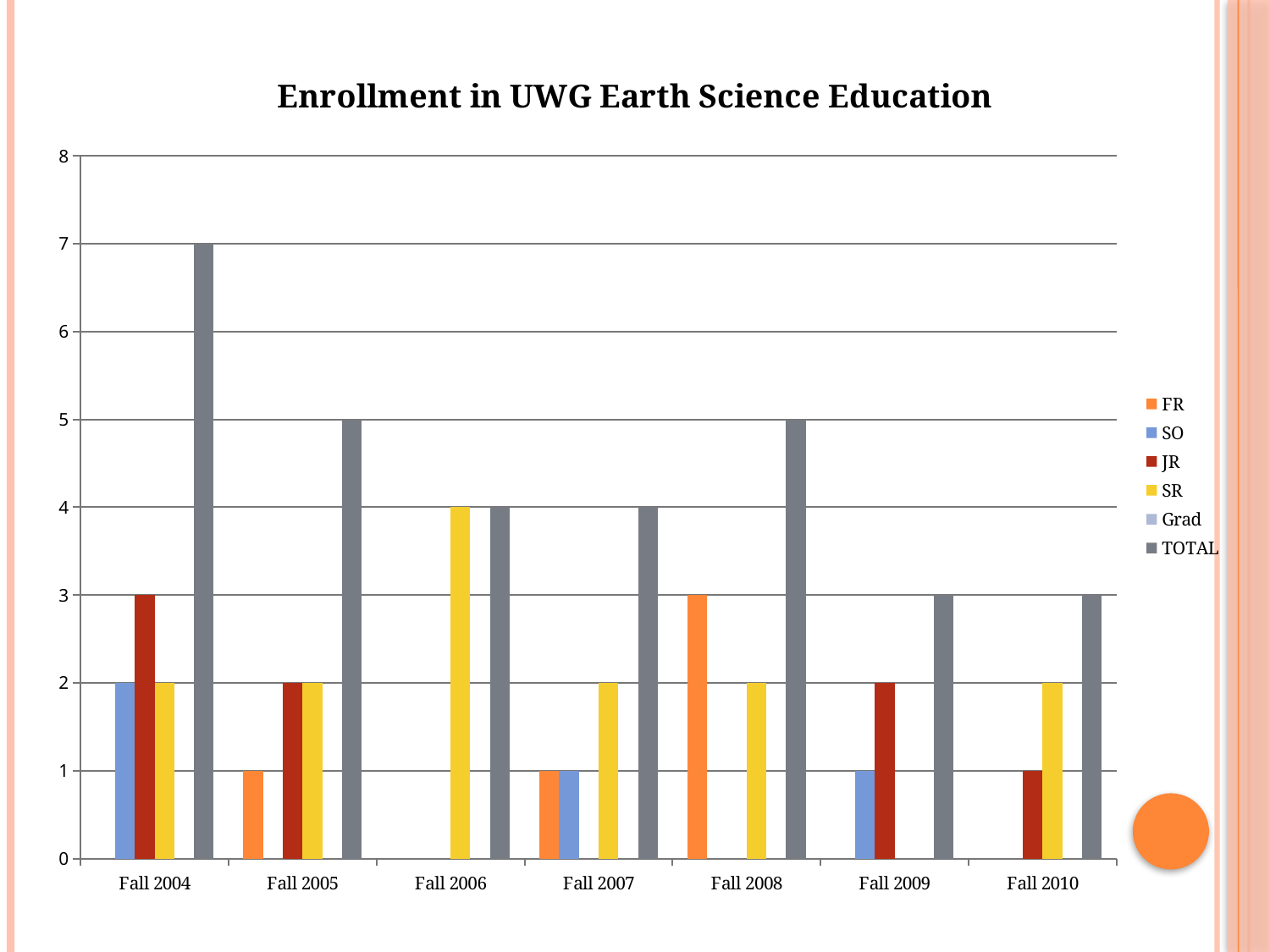
What is the FR value for Fall 2008? 3 What is the JR value for Fall 2009? 2 What is the title of the chart? Enrollment in UWG Earth Science Education What kind of chart is shown on the slide? Bar chart What is the TOTAL enrollment for Fall 2004? 7 Which semester has the highest TOTAL enrollment? Fall 2004 What is the difference between the TOTAL for Fall 2004 and the TOTAL for Fall 2005? 2 Which is larger, the TOTAL for Fall 2008 or the TOTAL for Fall 2009? Fall 2008 How many series does the legend list? 6 Is the TOTAL value for Fall 2004 greater or less than 6? greater How many semesters are shown on the x axis? 7 What is the SR value for Fall 2006? 4